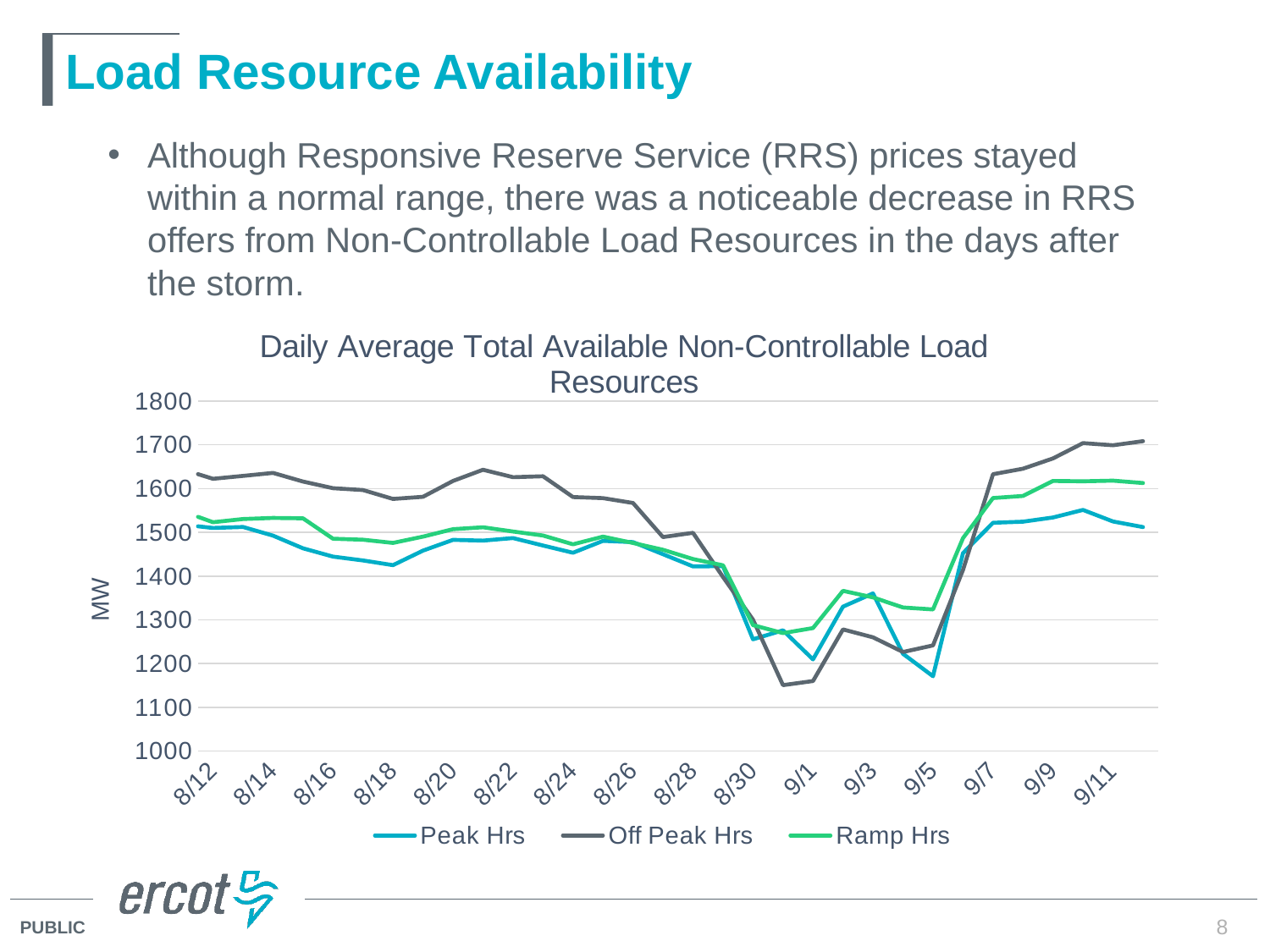
Which series has the lowest value on 9/5? Peak Hrs Is the Off Peak Hrs value on 9/11 greater or less than 1600? greater What is the label on the chart's vertical axis? MW How many series does the chart legend list? 3 Is the Peak Hrs value on 8/12 greater or less than 1400? greater Is the Off Peak Hrs value on 9/1 greater or less than 1200? less Which series has the highest value on 9/11? Off Peak Hrs Do the Off Peak Hrs values rise or fall between 9/5 and 9/9? rise What kind of chart is shown on the slide? line chart On 9/9, which is higher: Ramp Hrs or Peak Hrs? Ramp Hrs What are the three series named in the chart legend? Peak Hrs, Off Peak Hrs, Ramp Hrs